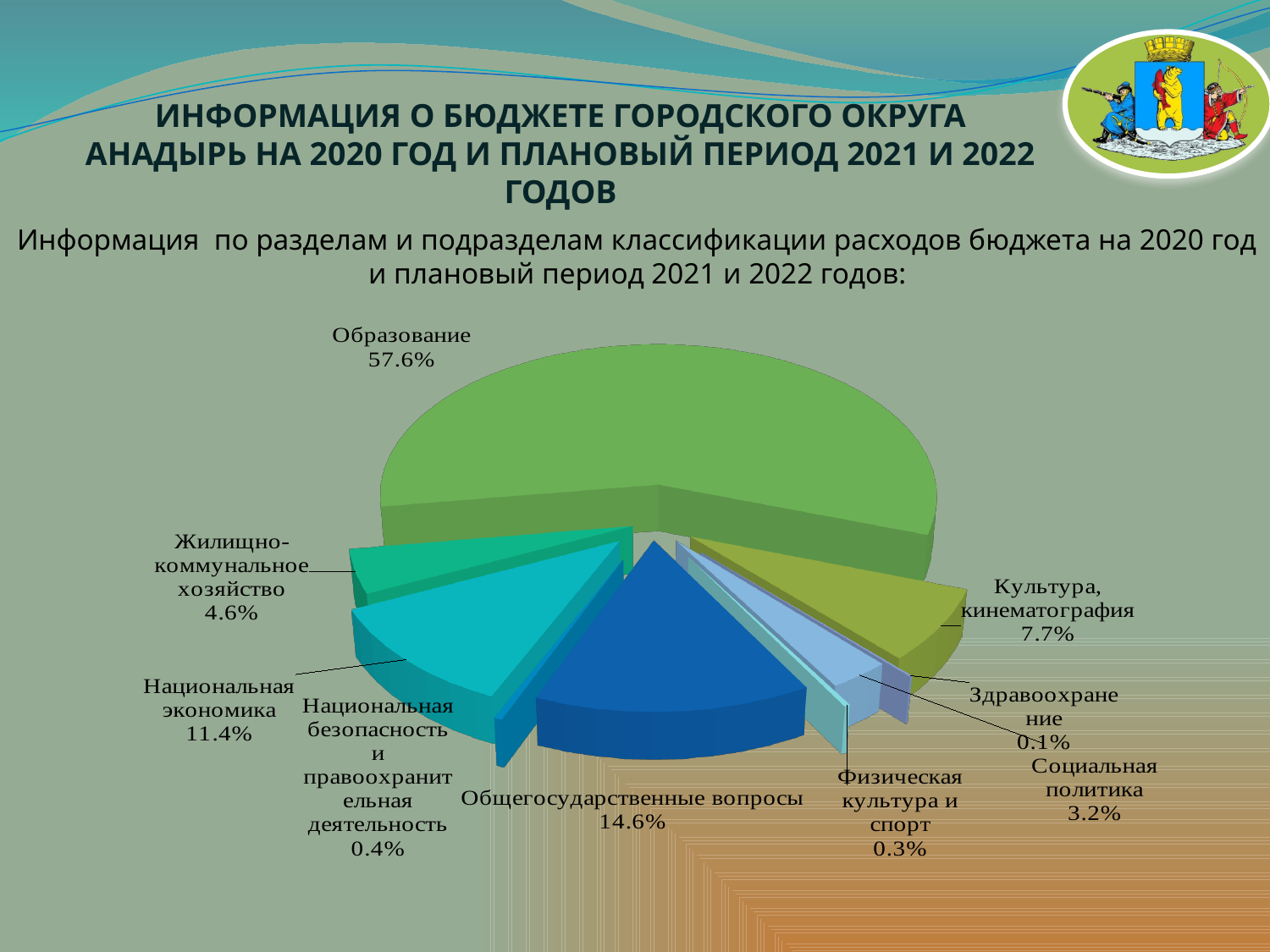
Which category has the smallest slice of the pie? Здравоохранение How many categories are shown in the pie chart? 9 What is the difference between the values for Общегосударственные вопросы and Национальная экономика? 3.2% What is the value shown for Национальная экономика? 11.4% What is the value shown for Здравоохранение? 0.1% What share of the pie does Образование have? 57.6% What is the difference between the values for Образование and Культура, кинематография? 49.9% Which category has the largest slice of the pie? Образование What kind of chart is shown on the slide? Pie chart What is the value shown for Общегосударственные вопросы? 14.6% Which is larger, Жилищно-коммунальное хозяйство or Социальная политика? Жилищно-коммунальное хозяйство What is the value shown for Культура, кинематография? 7.7%